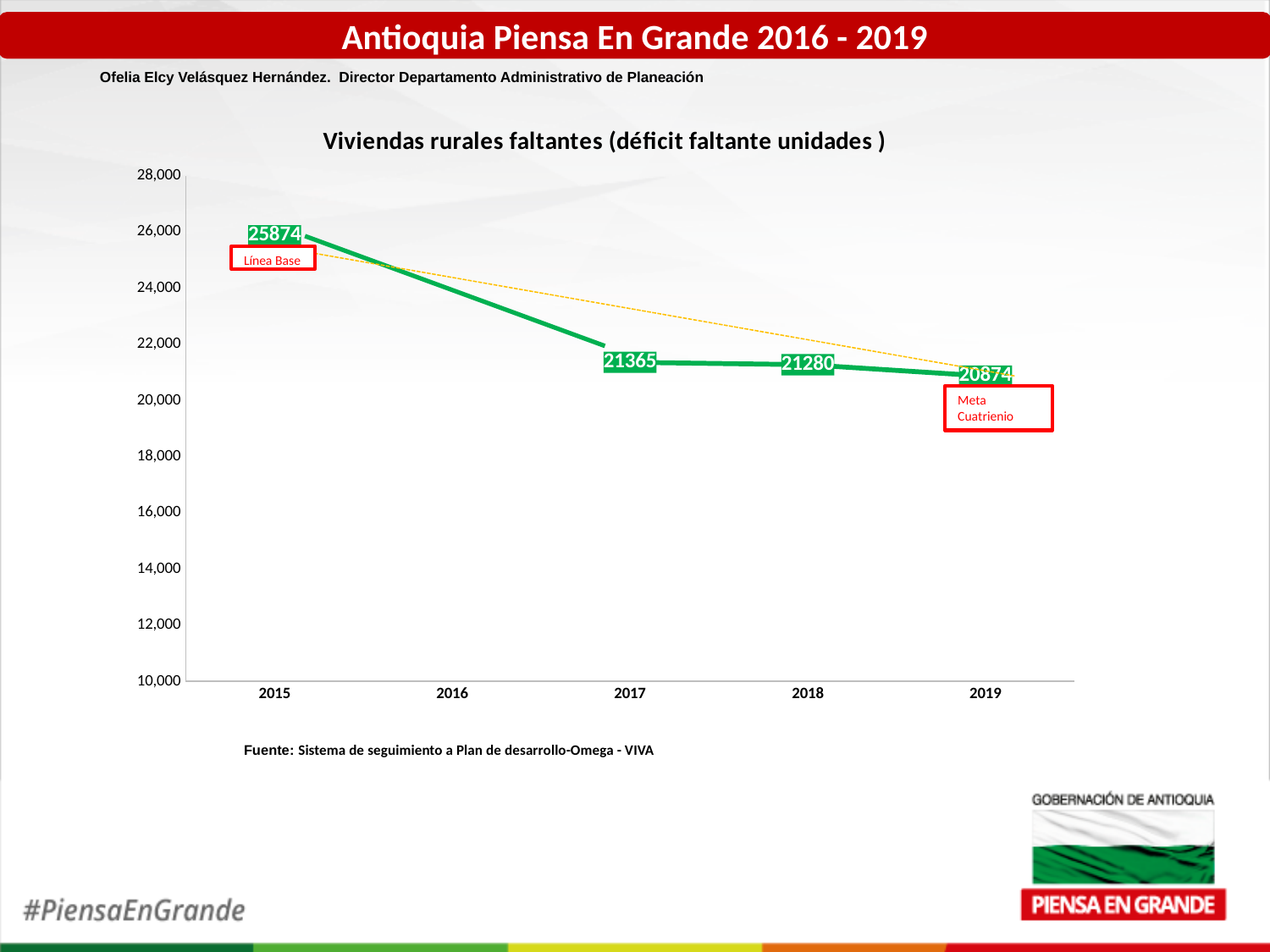
What is the difference between the values for 2015 and 2019? 5000 What kind of chart is shown on the slide? line chart How many years are shown on the x axis of the chart? 5 Which year has the highest value in the chart? 2015 What is the value for 2017 in the chart? 21365 What is the value for 2018 in the chart? 21280 Which year has the lowest value in the chart? 2019 Do the values rise or fall from 2015 to 2019? fall Which is larger, the value for 2017 or the value for 2018? 2017 What is the value for 2015 in the chart? 25874 What is the value for 2019 in the chart? 20874